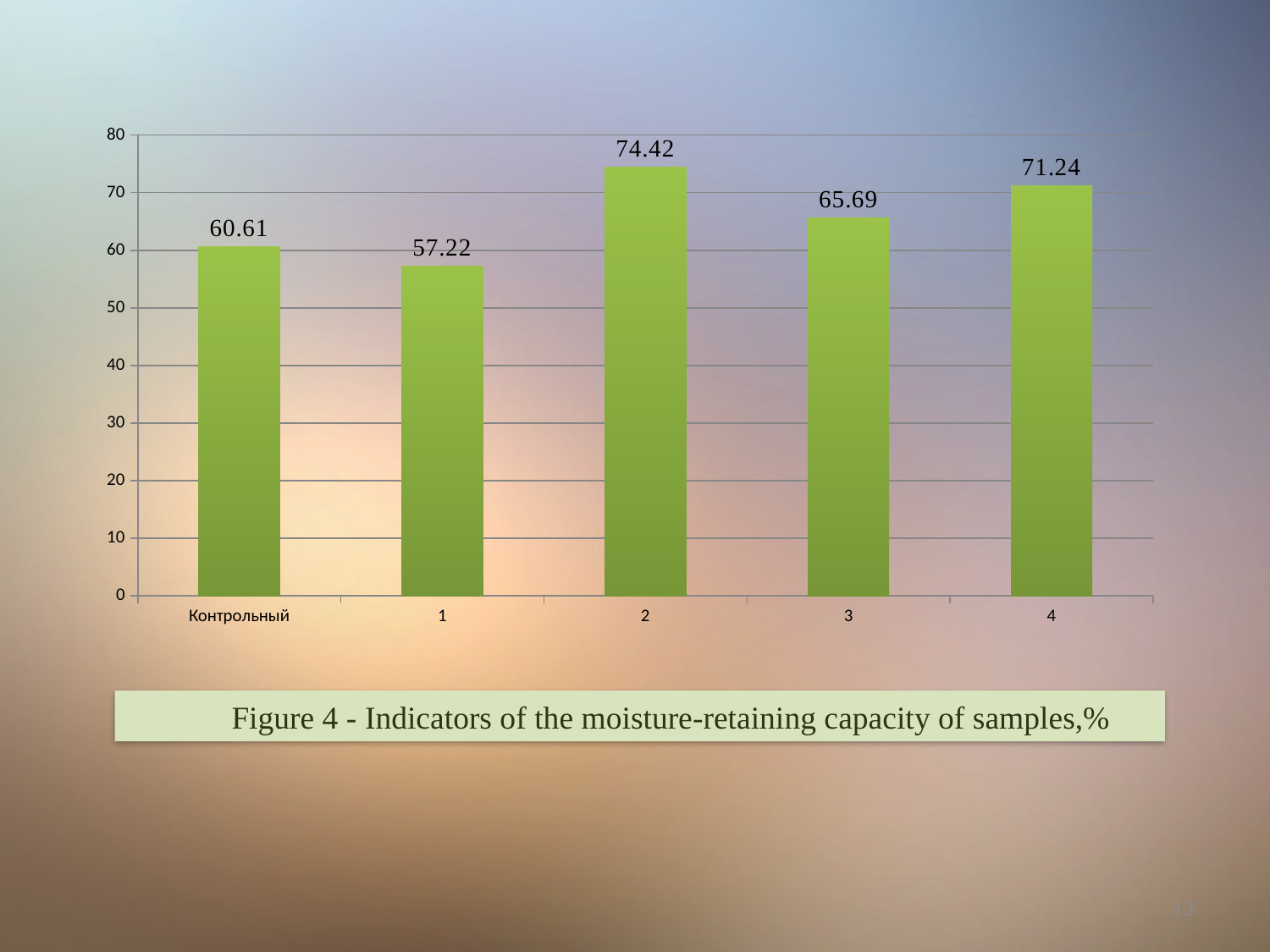
Which sample has the lowest moisture-retaining capacity? 1 How many samples are shown on the chart? 5 What is the difference between the values for sample 2 and sample 1? 17.20 What is the difference between the values for sample 4 and sample 3? 5.55 What is the value for sample 4? 71.24 What kind of chart is shown on the slide? bar chart Which is larger, the value for sample 3 or the value for the Контрольный sample? 3 What is the value for the Контрольный sample? 60.61 What is the value for sample 2? 74.42 Which sample has the highest moisture-retaining capacity? 2 What is the caption of the figure shown on the slide? Figure 4 - Indicators of the moisture-retaining capacity of samples,% Is the value for sample 1 greater or less than 60? less